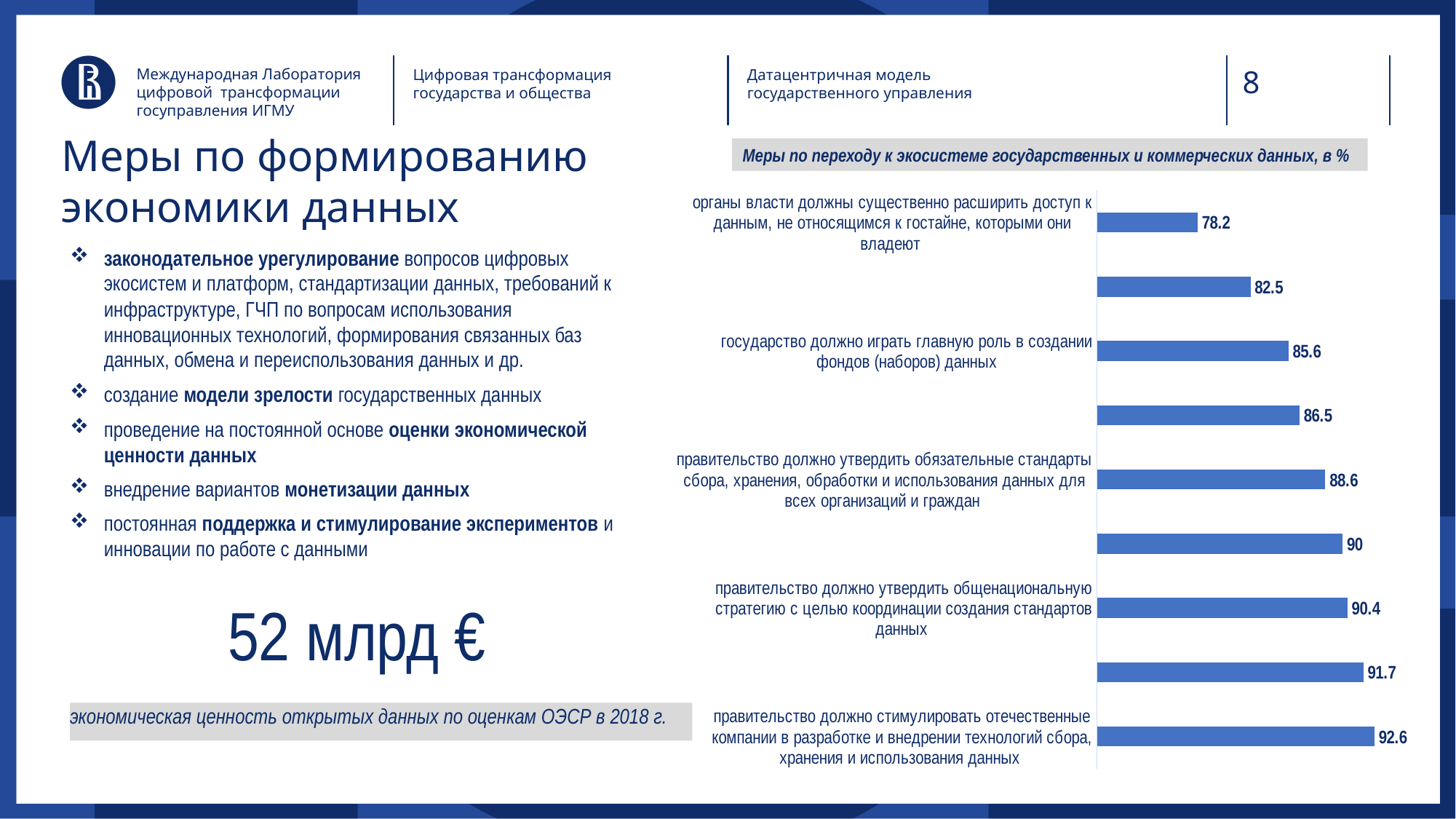
What is the value for "правительство должно стимулировать отечественные компании в разработке и внедрении технологий сбора, хранения и использования данных"? 92.6 What is the value for "правительство должно утвердить обязательные стандарты сбора, хранения, обработки и использования данных для всех организаций и граждан"? 88.6 What is the difference between the highest value (92.6) and the lowest value (78.2) in the chart? 14.4 Which is larger: the value for "государство должно играть главную роль в создании фондов (наборов) данных" or the value for "правительство должно утвердить обязательные стандарты сбора, хранения, обработки и использования данных для всех организаций и граждан"? правительство должно утвердить обязательные стандарты сбора, хранения, обработки и использования данных для всех организаций и граждан Do the bar values increase or decrease from the top of the chart to the bottom? increase What type of chart is shown on the slide? bar chart Which category has the lowest value in the chart? органы власти должны существенно расширить доступ к данным, не относящимся к гостайне, которыми они владеют What is the title of the chart? Меры по переходу к экосистеме государственных и коммерческих данных, в % What is the value for "государство должно играть главную роль в создании фондов (наборов) данных"? 85.6 Which category has the highest value in the chart? правительство должно стимулировать отечественные компании в разработке и внедрении технологий сбора, хранения и использования данных How many bars are plotted in the chart? 9 What is the value for "правительство должно утвердить общенациональную стратегию с целью координации создания стандартов данных"? 90.4